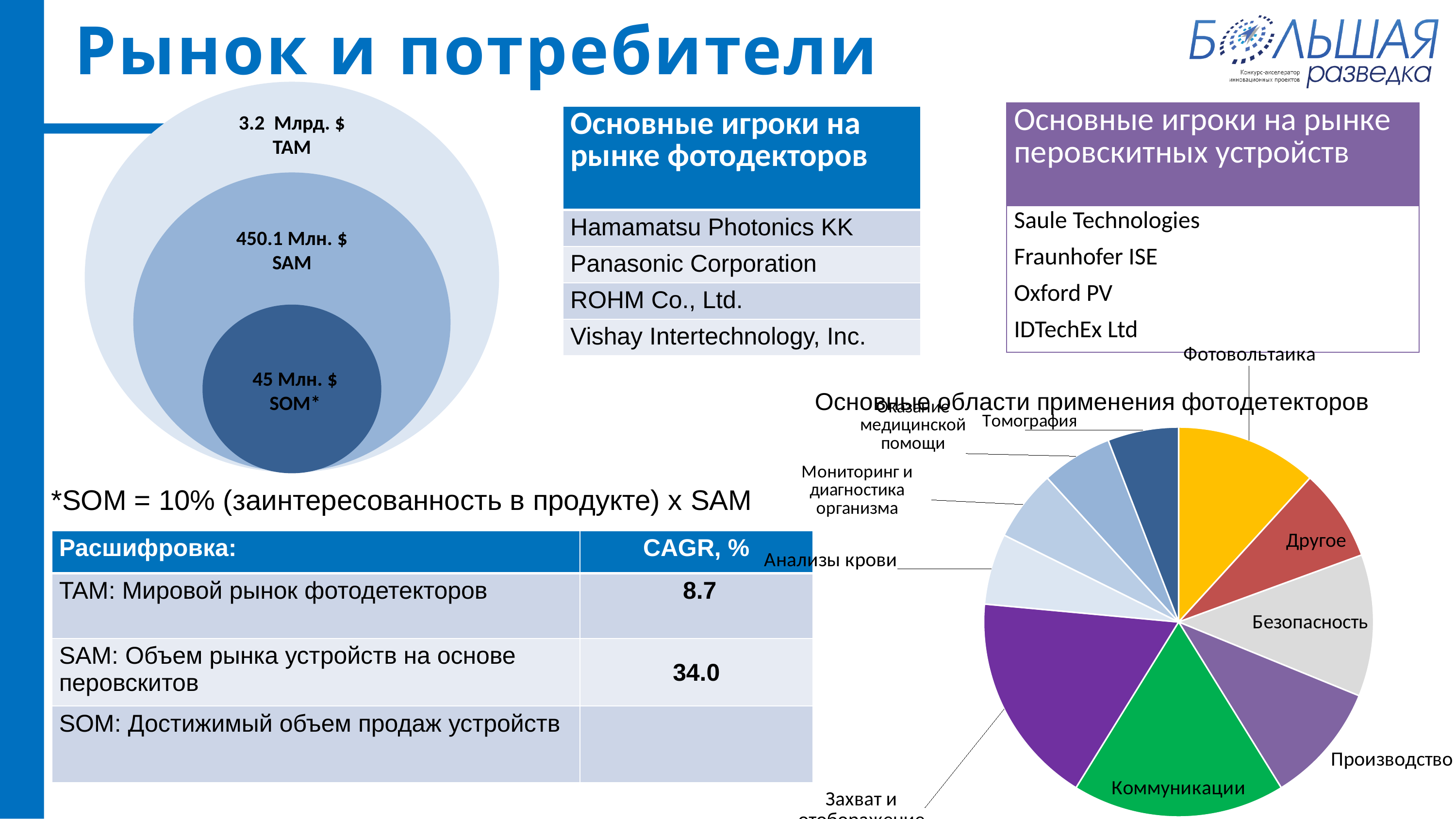
In the pie chart 'Основные области применения фотодетекторов', which slice is larger: Коммуникации or Томография? Коммуникации In the pie chart 'Основные области применения фотодетекторов', which slice is larger: Производство or Безопасность? Безопасность What colour is the Фотовольтаика slice in the pie chart 'Основные области применения фотодетекторов'? yellow What colour is the Коммуникации slice in the pie chart 'Основные области применения фотодетекторов'? green In the nested circle diagram on the left of the slide, which is the largest circle: TAM, SAM or SOM? TAM In the nested circle diagram on the left of the slide, what value is shown for SOM*? 45 Млн. $ In the nested circle diagram on the left of the slide, what value is shown for TAM? 3.2 Млрд. $ How many slices does the pie chart 'Основные области применения фотодетекторов' have? 10 What kind of chart is 'Основные области применения фотодетекторов'? pie chart In the nested circle diagram on the left of the slide, what value is shown for SAM? 450.1 Млн. $ In the pie chart 'Основные области применения фотодетекторов', which slice is larger: Фотовольтаика or Другое? Фотовольтаика